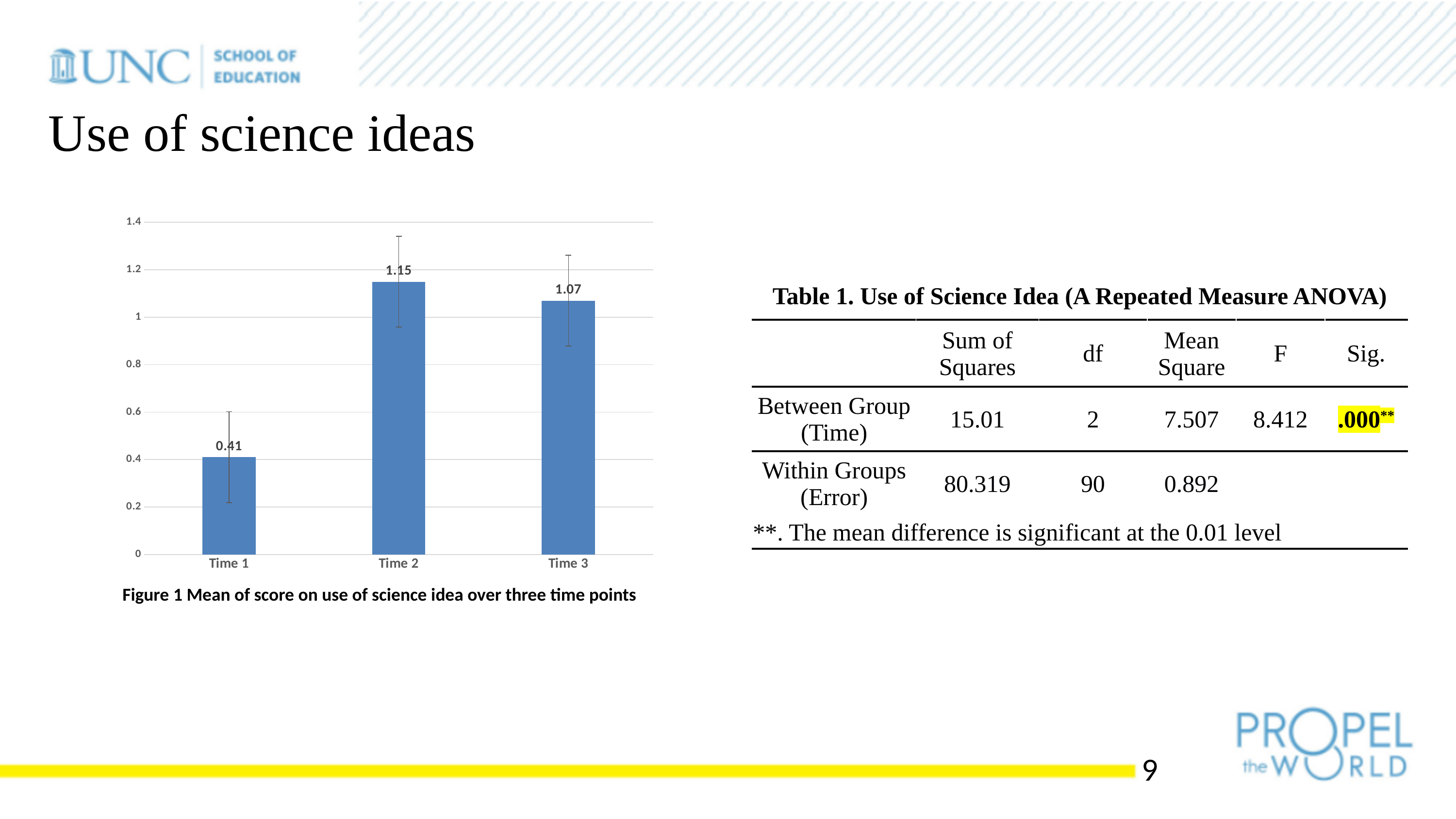
What is the difference between the values for Time 2 and Time 1? 0.74 What is the difference between the values for Time 2 and Time 3? 0.08 Which time point has the lowest value? Time 1 What is the value for Time 3? 1.07 What is the value for Time 1? 0.41 How many time points are shown in the chart? 3 Which is larger, the value for Time 1 or the value for Time 3? Time 3 Which time point has the highest value? Time 2 What is the value for Time 2? 1.15 What kind of chart is shown on the slide? bar chart What is the caption of the figure below the chart? Figure 1 Mean of score on use of science idea over three time points Is the value for Time 1 greater or less than 0.6? less